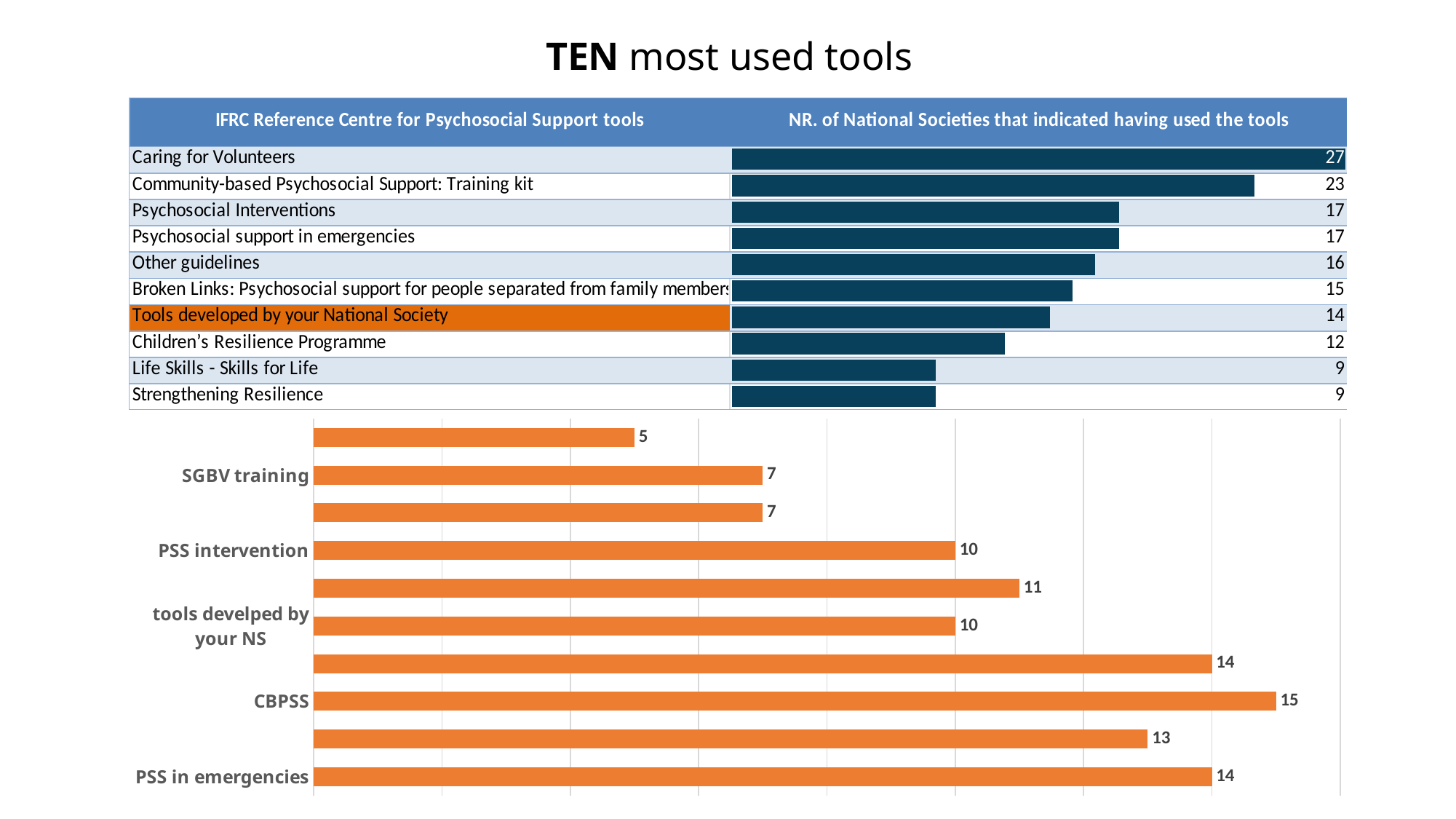
In the bar chart at the bottom, what is the value for PSS intervention? 10 In the bar chart at the bottom, what is the value for SGBV training? 7 In the bar chart at the bottom, which labelled category has the highest value? CBPSS In the bar chart at the bottom, how many bars are plotted? 10 In the table with bars at the top, what is the difference between the values for Caring for Volunteers and Community-based Psychosocial Support: Training kit? 4 In the bar chart at the bottom, what is the value for PSS in emergencies? 14 In the table with bars at the top, which tool has the highest number of National Societies that indicated having used it? Caring for Volunteers In the bar chart at the bottom, what is the value for CBPSS? 15 In the bar chart at the bottom, which is larger: the value for PSS in emergencies or the value for PSS intervention? PSS in emergencies In the bar chart at the bottom, what is the difference between the values for CBPSS and SGBV training? 8 In the table with bars at the top, how many National Societies indicated having used Tools developed by your National Society? 14 What kind of chart is shown at the bottom of the slide? bar chart